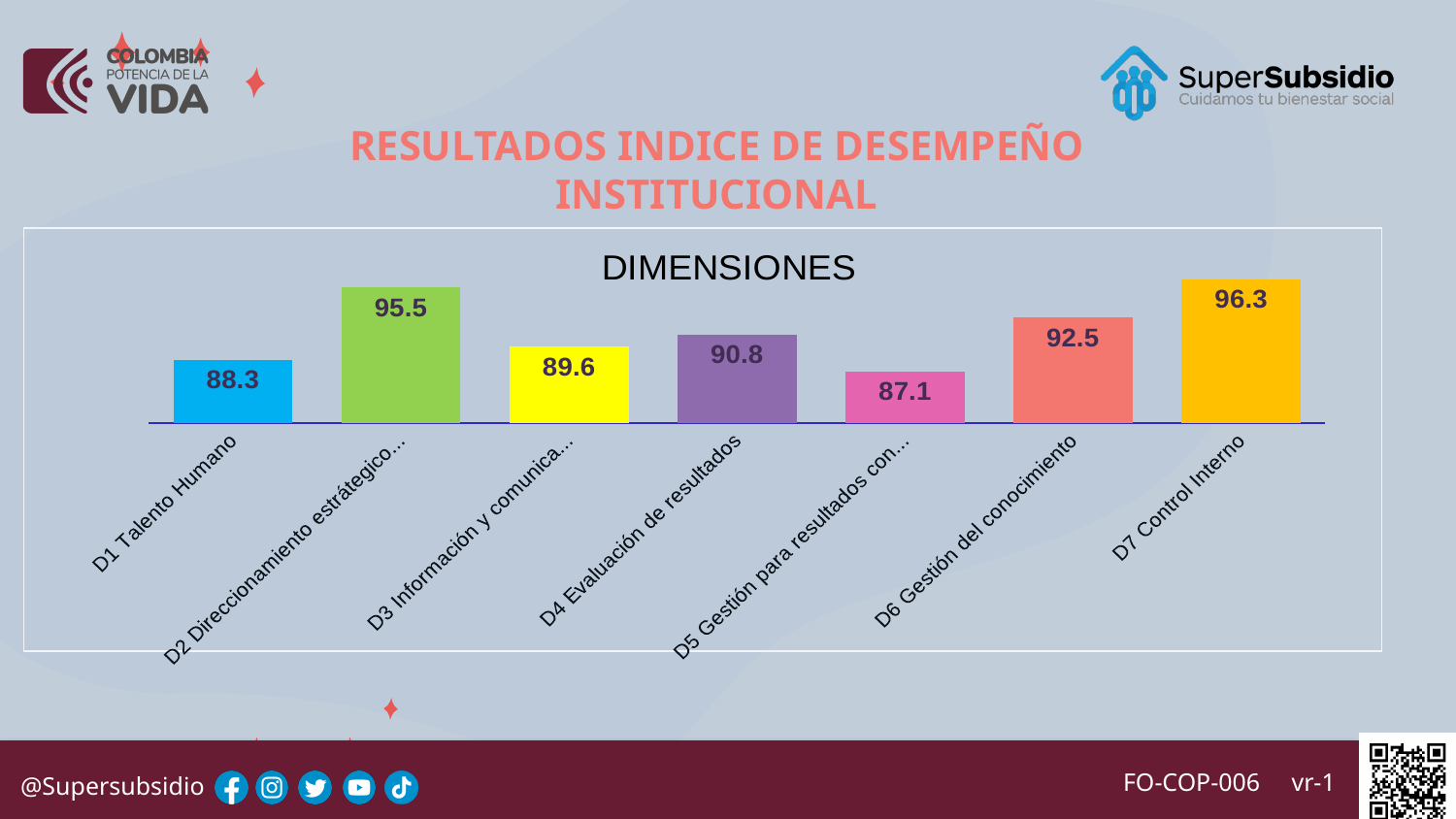
Which dimension has the lowest value? D5 Gestión para resultados con... What is the difference between the values for D7 Control Interno and D1 Talento Humano? 8.0 Which is larger, the value for D2 Direccionamiento estratégico or the value for D6 Gestión del conocimiento? D2 Direccionamiento estratégico What is the value for D4 Evaluación de resultados? 90.8 How many dimensions are shown in the chart? 7 What is the value for D1 Talento Humano? 88.3 What is the title of the chart? DIMENSIONES What is the value for D7 Control Interno? 96.3 Which dimension has the highest value? D7 Control Interno What kind of chart is shown on the slide? Bar chart What is the difference between the values for D6 Gestión del conocimiento and D4 Evaluación de resultados? 1.7 What is the value for D6 Gestión del conocimiento? 92.5